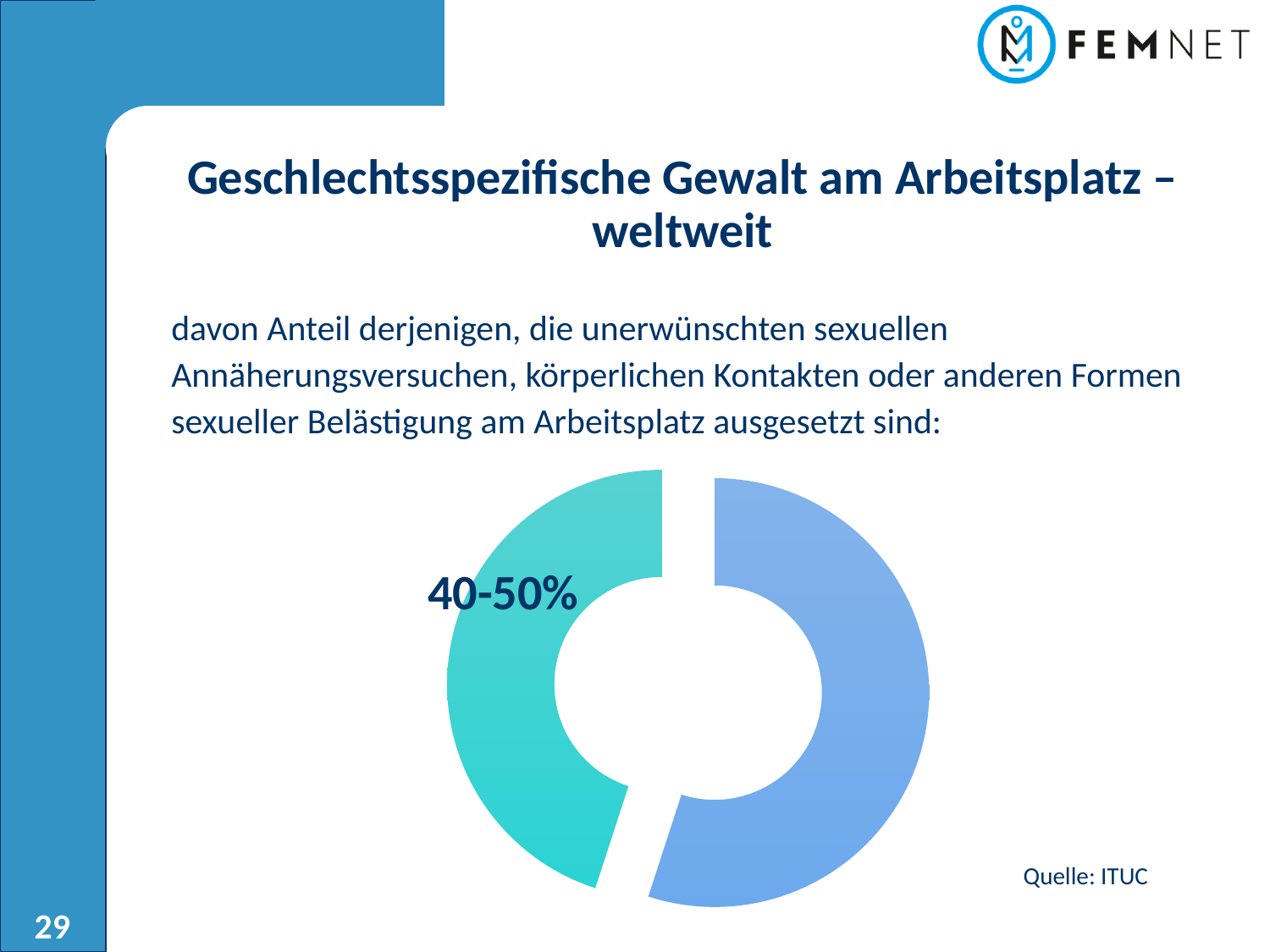
What colour is the slice that carries the data label in the donut chart? teal What kind of chart is shown on the slide? donut (pie) chart Is the share shown by the labelled teal slice greater or less than 50%? less What share of the donut chart does the labelled slice represent? 40-50% Which slice of the donut chart is larger, the teal one or the blue one? the blue one What source is cited for the chart on the slide? ITUC What value is printed on the teal slice of the donut chart? 40-50% How many slices does the donut chart have? 2